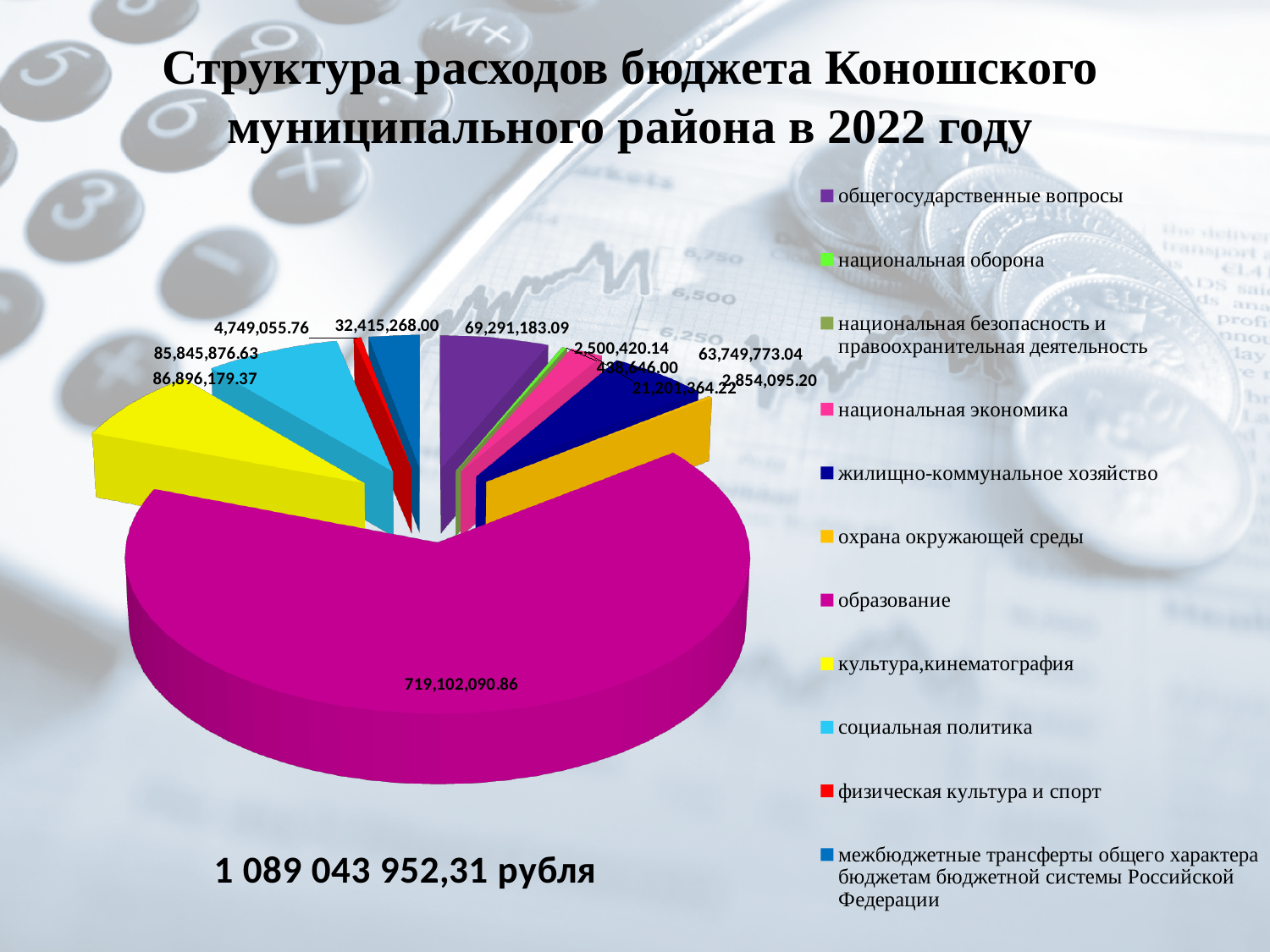
What is the value shown for социальная политика? 85,845,876.63 What is the value shown for межбюджетные трансферты общего характера бюджетам бюджетной системы Российской Федерации? 32,415,268.00 What is the difference between the values for культура,кинематография and социальная политика? 1,050,302.74 What kind of chart is shown on the slide? Pie chart Which category has the largest slice of the pie chart? образование What is the value shown for культура,кинематография? 86,896,179.37 What total amount is printed below the pie chart? 1 089 043 952,31 рубля How many categories does the legend of the pie chart list? 11 What is the value shown for образование? 719,102,090.86 What is the value shown for общегосударственные вопросы? 69,291,183.09 What is the value shown for физическая культура и спорт? 4,749,055.76 Which is larger, the value for культура,кинематография or the value for социальная политика? культура,кинематография